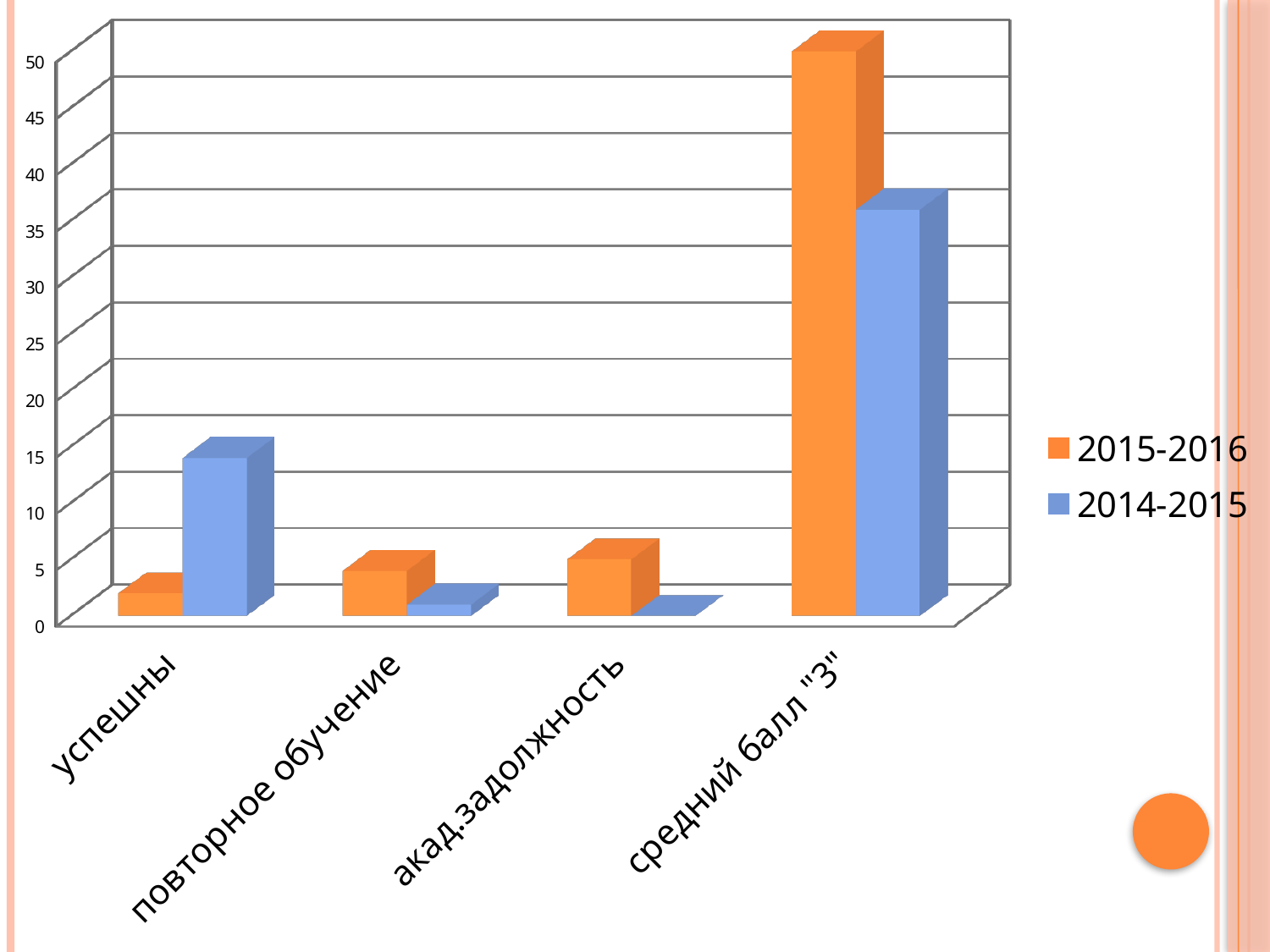
Which colour represents the 2014-2015 series in the legend? blue How many series does the legend list? 2 For the category средний балл "3", which series has the larger value, 2015-2016 or 2014-2015? 2015-2016 Is the 2015-2016 value for средний балл "3" greater or less than 45? greater For the category успешны, which series has the larger value, 2015-2016 or 2014-2015? 2014-2015 Is the 2014-2015 value for успешны greater or less than 10? greater Which category has the highest value for the 2015-2016 series? средний балл "3" Is the 2014-2015 value for средний балл "3" greater or less than 30? greater What kind of chart is shown on the slide? bar chart Which category has the lowest value for the 2014-2015 series? акад.задолжность How many categories are shown on the x axis? 4